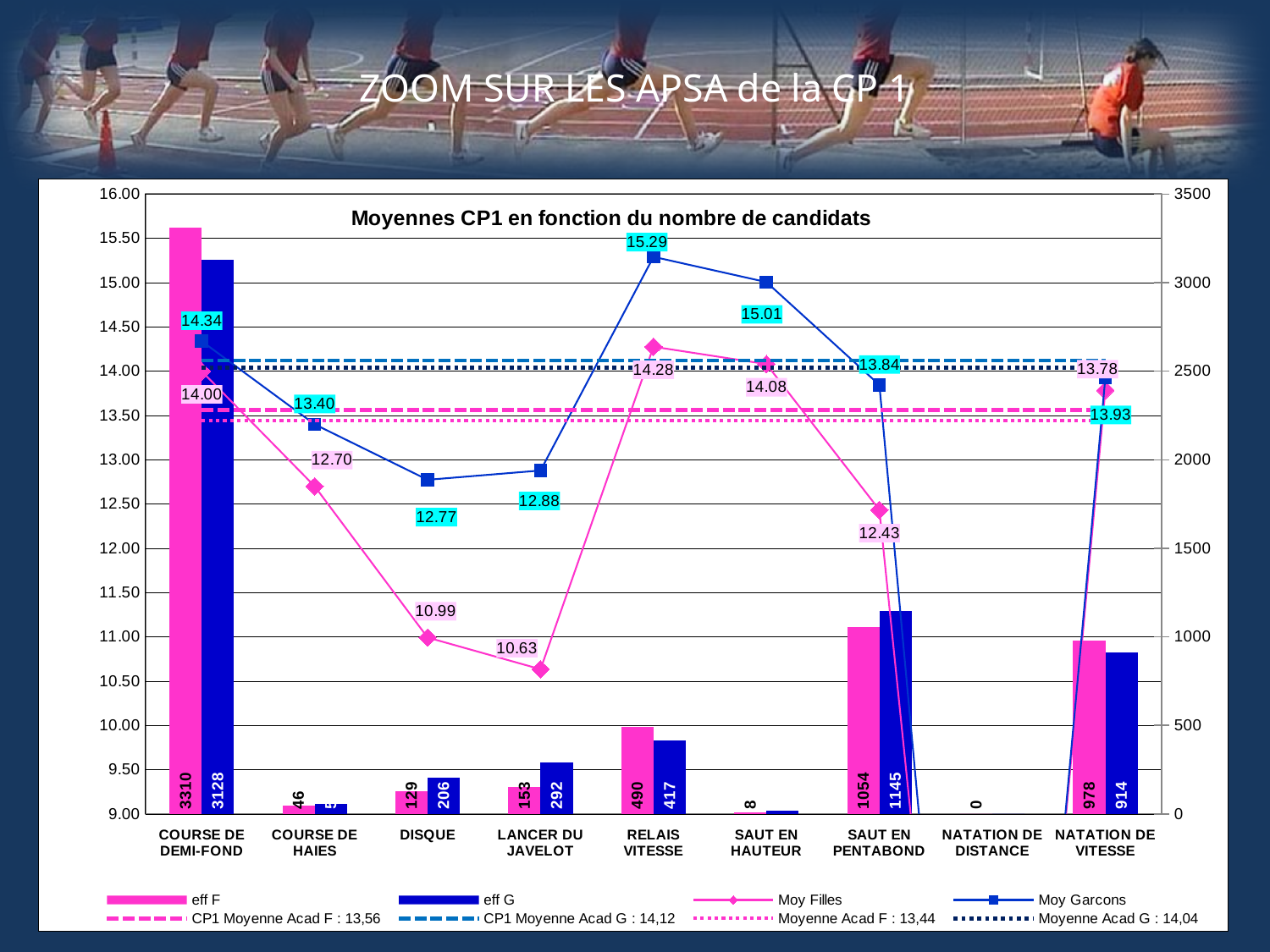
Which category has the highest eff F bar? COURSE DE DEMI-FOND What is the difference between eff G and eff F for SAUT EN PENTABOND? 91 For RELAIS VITESSE, which is larger, eff F or eff G? eff F What is the Moy Garcons value for RELAIS VITESSE? 15.29 What is the Moy Filles value for DISQUE? 10.99 Which category has the highest Moy Garcons value? RELAIS VITESSE How many entries does the legend list? 8 Which category has the lowest Moy Filles value? LANCER DU JAVELOT What is the eff G value for LANCER DU JAVELOT? 292 What is the difference between Moy Garcons and Moy Filles for SAUT EN HAUTEUR? 0.93 What is the eff F value for COURSE DE DEMI-FOND? 3310 How many categories are shown on the x axis? 9